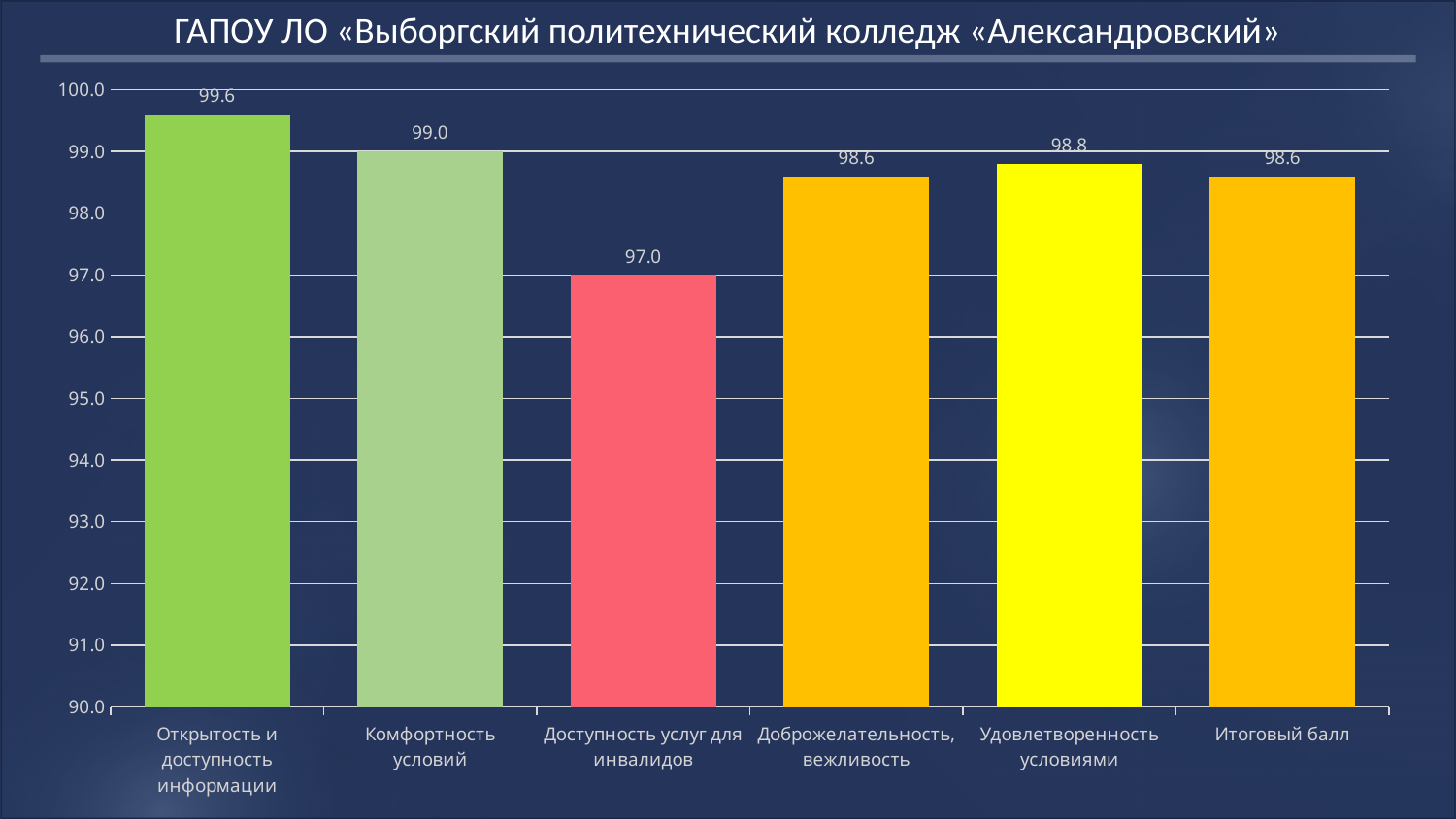
What is the difference between the values for «Открытость и доступность информации» and «Доступность услуг для инвалидов»? 2.6 Which category has the highest value? Открытость и доступность информации Which is larger: the value for «Комфортность условий» or the value for «Удовлетворенность условиями»? Комфортность условий How many categories are shown in the chart? 6 What kind of chart is shown on the slide? bar chart What colour is the bar for «Доступность услуг для инвалидов»? red What is the value for «Доступность услуг для инвалидов»? 97.0 Which category has the lowest value? Доступность услуг для инвалидов What is the value for «Открытость и доступность информации»? 99.6 What is the value for «Итоговый балл»? 98.6 What is the value for «Удовлетворенность условиями»? 98.8 Is the value for «Доброжелательность, вежливость» greater or less than 98.0? greater